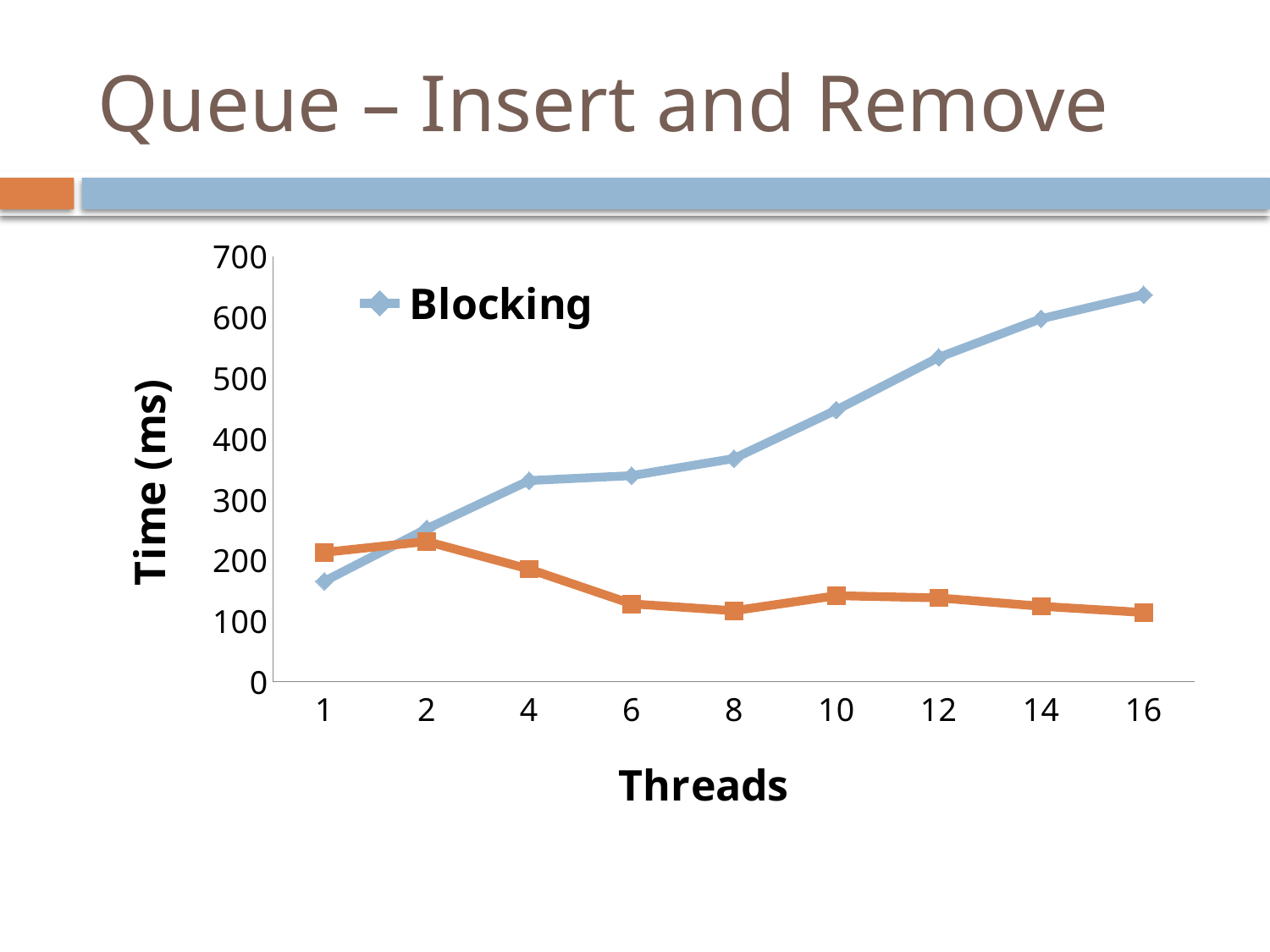
Is the Blocking value at 1 thread greater or less than 200? less Is the Blocking value at 16 threads greater or less than 600? greater Does the Blocking series rise or fall as the number of threads increases? rises How many series does the legend list? 1 What kind of chart is shown on the slide? line chart What is the name of the series shown in the legend? Blocking At which number of threads is the Blocking series highest? 16 At 16 threads, which is larger: the Blocking line or the orange line? Blocking What is the label of the y axis? Time (ms) Is the Blocking value at 10 threads greater or less than 400? greater How many thread counts are plotted along the x axis? 9